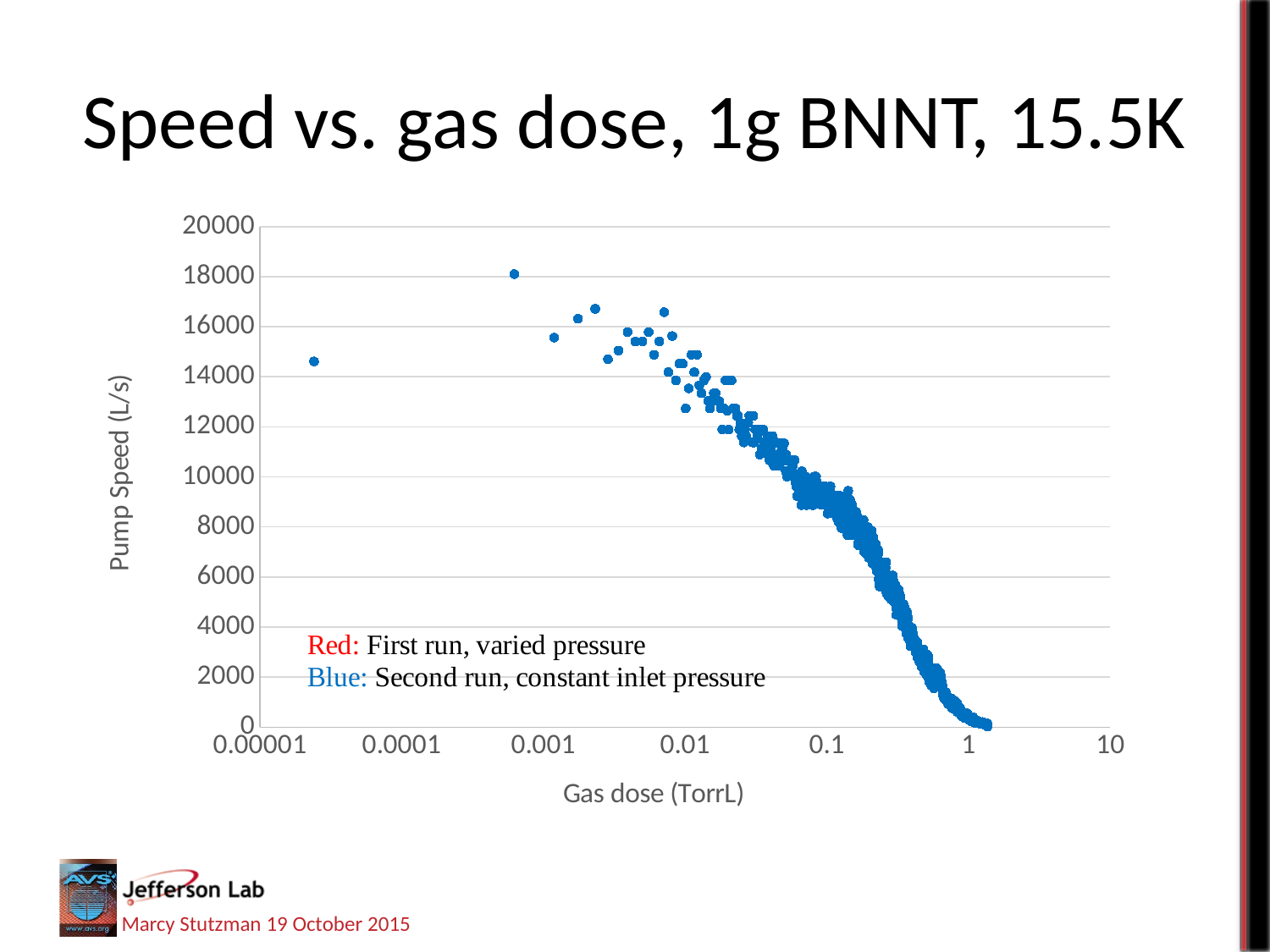
As gas dose increases along the x axis, does pump speed generally rise or fall? fall Is the pump speed at a gas dose of about 0.1 TorrL greater or less than 12000 L/s? less What kind of chart is shown on the slide? scatter plot Is the pump speed at a gas dose of about 1 TorrL greater or less than 2000 L/s? less Is the pump speed of the highest point on the chart greater or less than 16000 L/s? greater What is the maximum value shown on the y axis? 20000 What is the label of the y axis? Pump Speed (L/s) Which has the higher pump speed: the points near a gas dose of 0.001 TorrL or the points near a gas dose of 1 TorrL? the points near 0.001 TorrL What is the title of the chart? Speed vs. gas dose, 1g BNNT, 15.5K